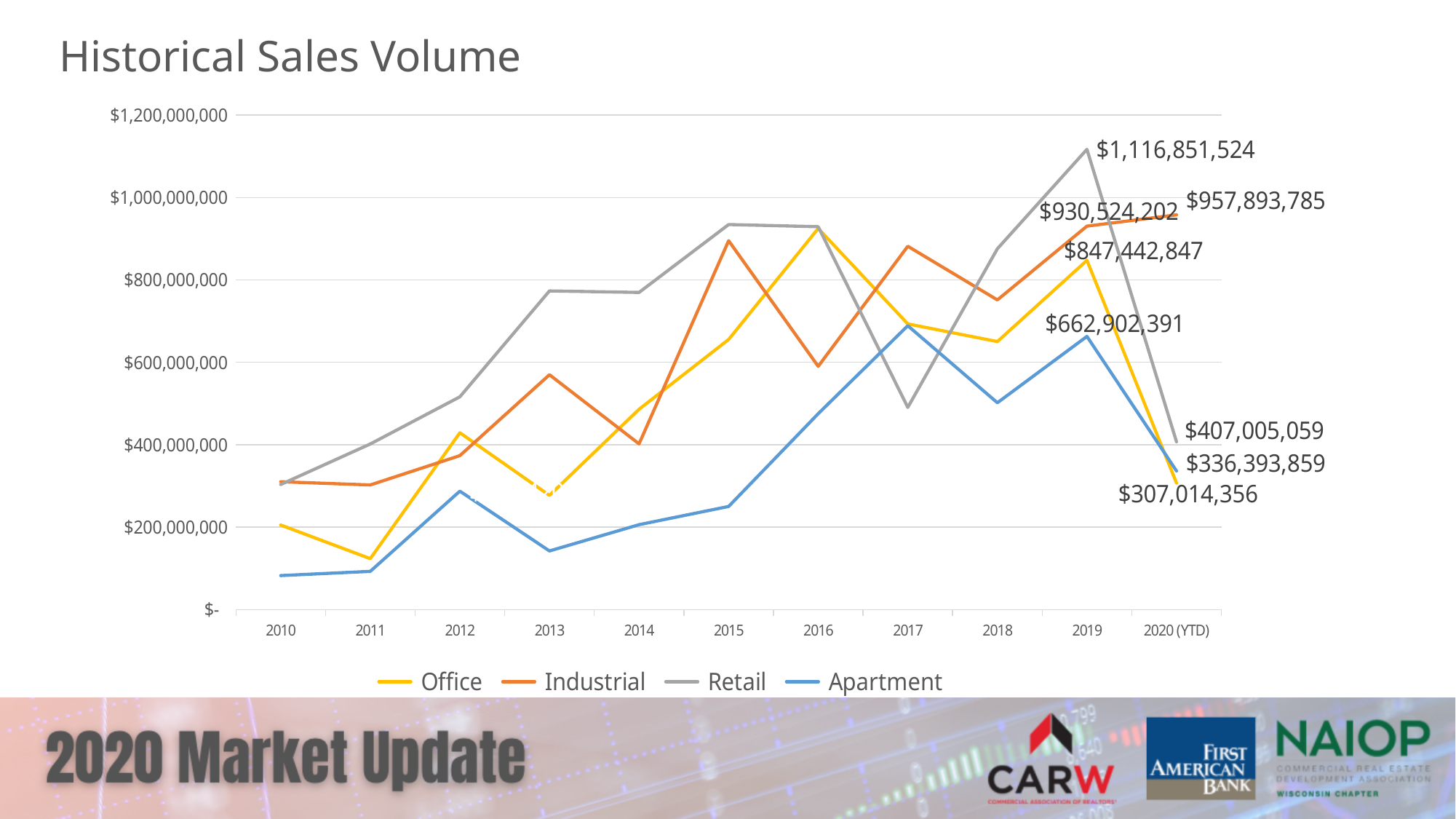
What is the Office sales volume for 2020 (YTD)? $307,014,356 Does the Apartment sales volume rise or fall from 2013 to 2017? rise How many series does the legend list? 4 How many years are shown along the x axis? 11 In 2019, which is larger: the Industrial or the Apartment sales volume? Industrial What is the Retail sales volume for 2019? $1,116,851,524 Which series has the highest sales volume in 2019? Retail What kind of chart is shown on the slide? line chart What is the difference between the Retail sales volume in 2019 and in 2020 (YTD)? $709,846,465 What is the Industrial sales volume for 2020 (YTD)? $957,893,785 Which series has the lowest sales volume in 2020 (YTD)? Office Is the Apartment sales volume for 2010 greater or less than $200,000,000? less